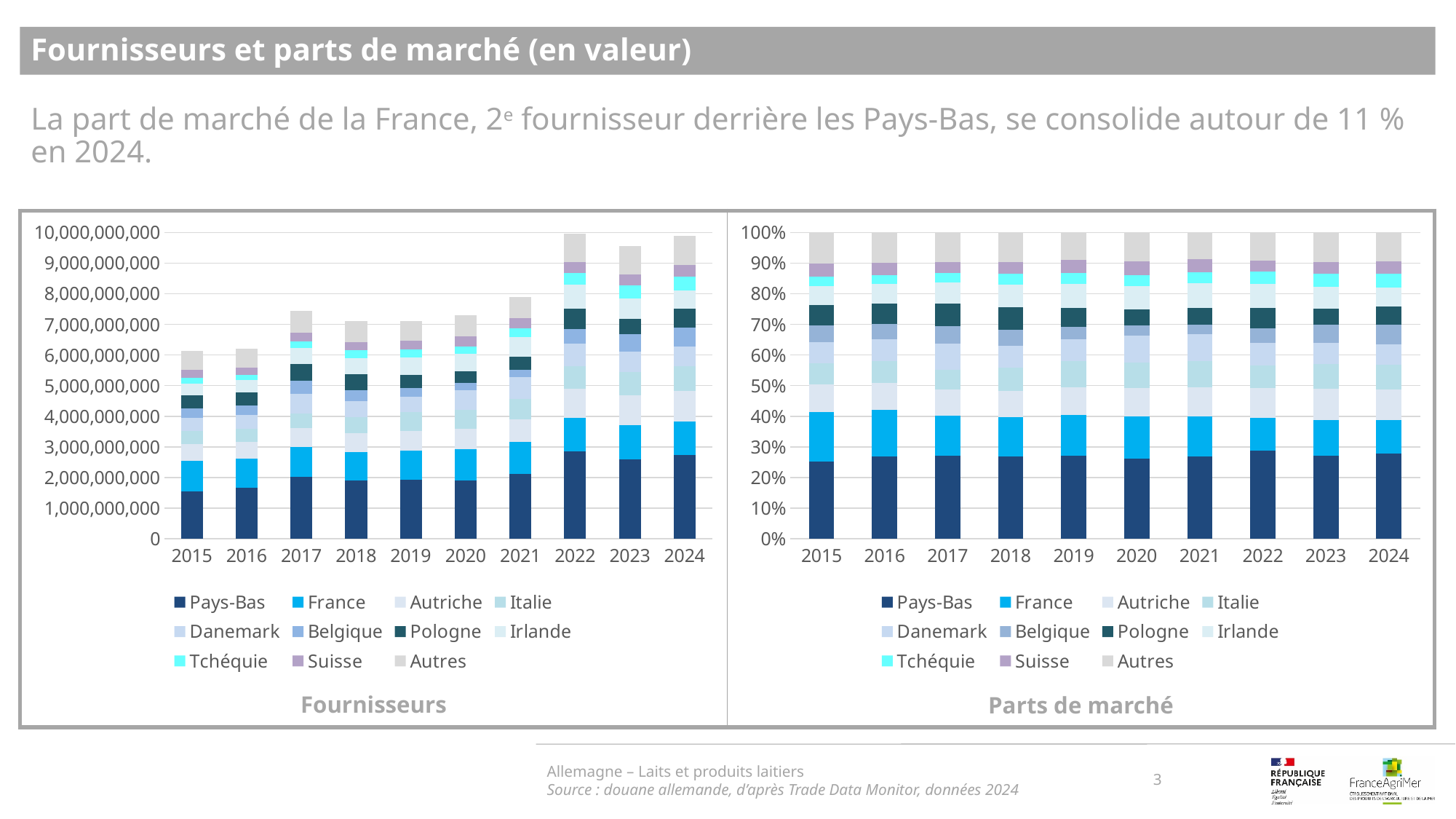
In the 'Parts de marché' chart, is the Pays-Bas share for 2022 greater or less than 30%? less In the 'Fournisseurs' chart, is the Pays-Bas value larger in 2015 or in 2024? 2024 In the 'Fournisseurs' chart, is the Pays-Bas value for 2024 greater or less than 3,000,000,000? less Which series is at the bottom of each stacked bar in the 'Parts de marché' chart? Pays-Bas How many years are shown on the x axis of the 'Parts de marché' chart? 10 In the 'Fournisseurs' chart, is the total stacked value for 2023 greater or less than 9,000,000,000? greater In the 'Fournisseurs' chart, which year has the larger total stacked value, 2021 or 2022? 2022 How many series does the legend of the 'Fournisseurs' chart list? 11 What kind of chart is the 'Fournisseurs' chart? stacked bar chart In the 'Fournisseurs' chart, does the Pays-Bas value generally rise or fall from 2015 to 2024? rise